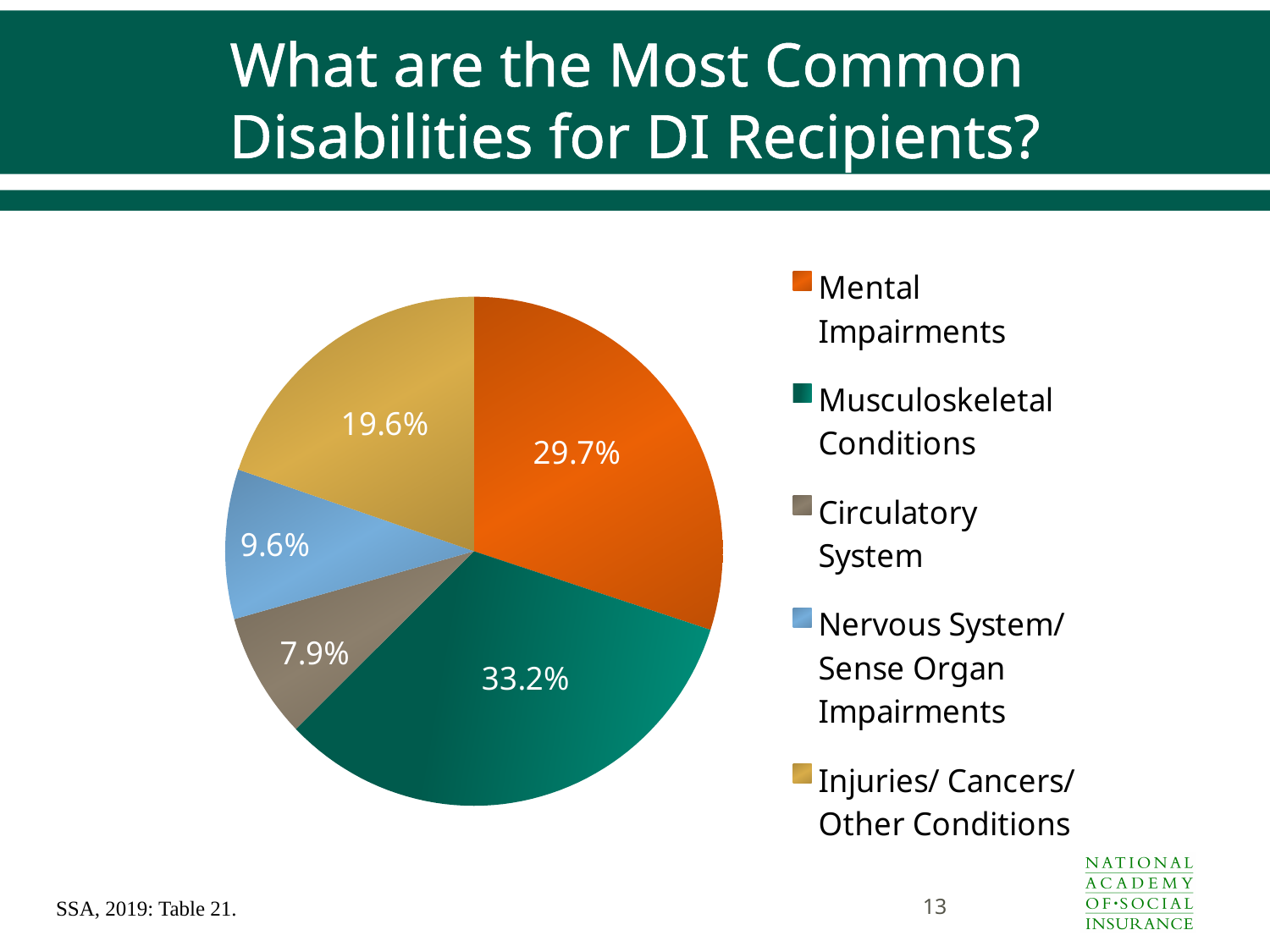
Which category has the smallest share of the pie? Circulatory System What share of DI recipients have Nervous System/ Sense Organ Impairments? 9.6% What is the difference in percentage points between Musculoskeletal Conditions and Mental Impairments? 3.5 What share of DI recipients fall under Injuries/ Cancers/ Other Conditions? 19.6% Which category has the largest share of the pie? Musculoskeletal Conditions What kind of chart is shown on the slide? Pie chart Which is larger, the share for Nervous System/ Sense Organ Impairments or the share for Circulatory System? Nervous System/ Sense Organ Impairments What share of DI recipients have Musculoskeletal Conditions? 33.2% What share of DI recipients have Mental Impairments? 29.7% What share of DI recipients have Circulatory System disabilities? 7.9% What colour is the slice for Mental Impairments? Orange How many categories does the pie chart show? 5